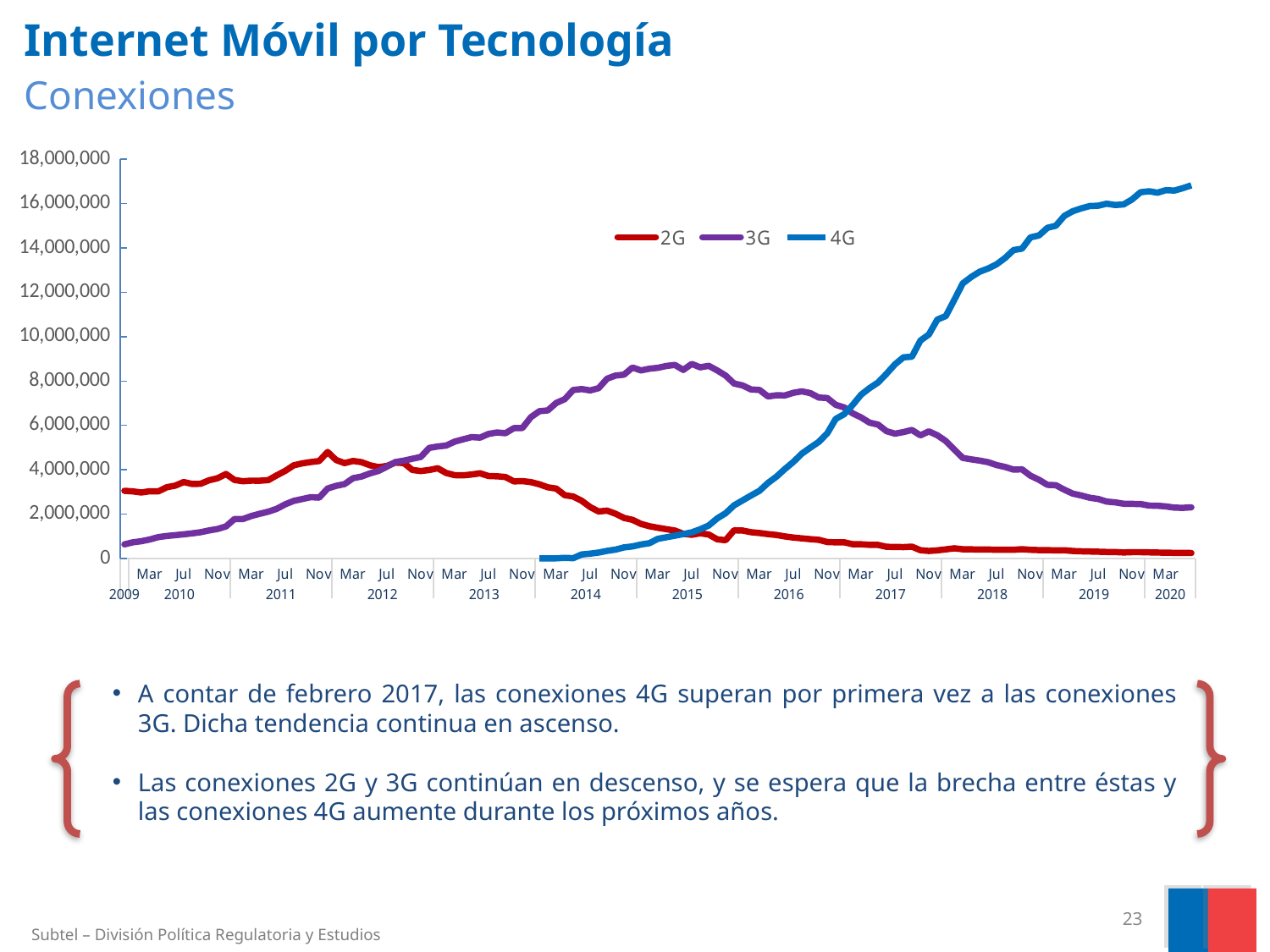
Does the 2G line rise or fall from 2012 to 2020? fall Which series has the highest value at the end of the chart in 2020? 4G In March 2015, which series has the larger value, 3G or 4G? 3G Which series has the lowest value at the end of the chart in 2020? 2G What kind of chart is shown on the slide? line chart Which series are listed in the chart legend? 2G, 3G, 4G Does the 4G line rise or fall from 2014 to 2020? rise Is the value for 4G in March 2020 greater or less than 16,000,000? greater Is the peak value of the 3G line greater or less than 8,000,000? greater What colour is the 4G line in the chart? blue How many series does the legend list? 3 Is the value for 2G in March 2020 greater or less than 2,000,000? less